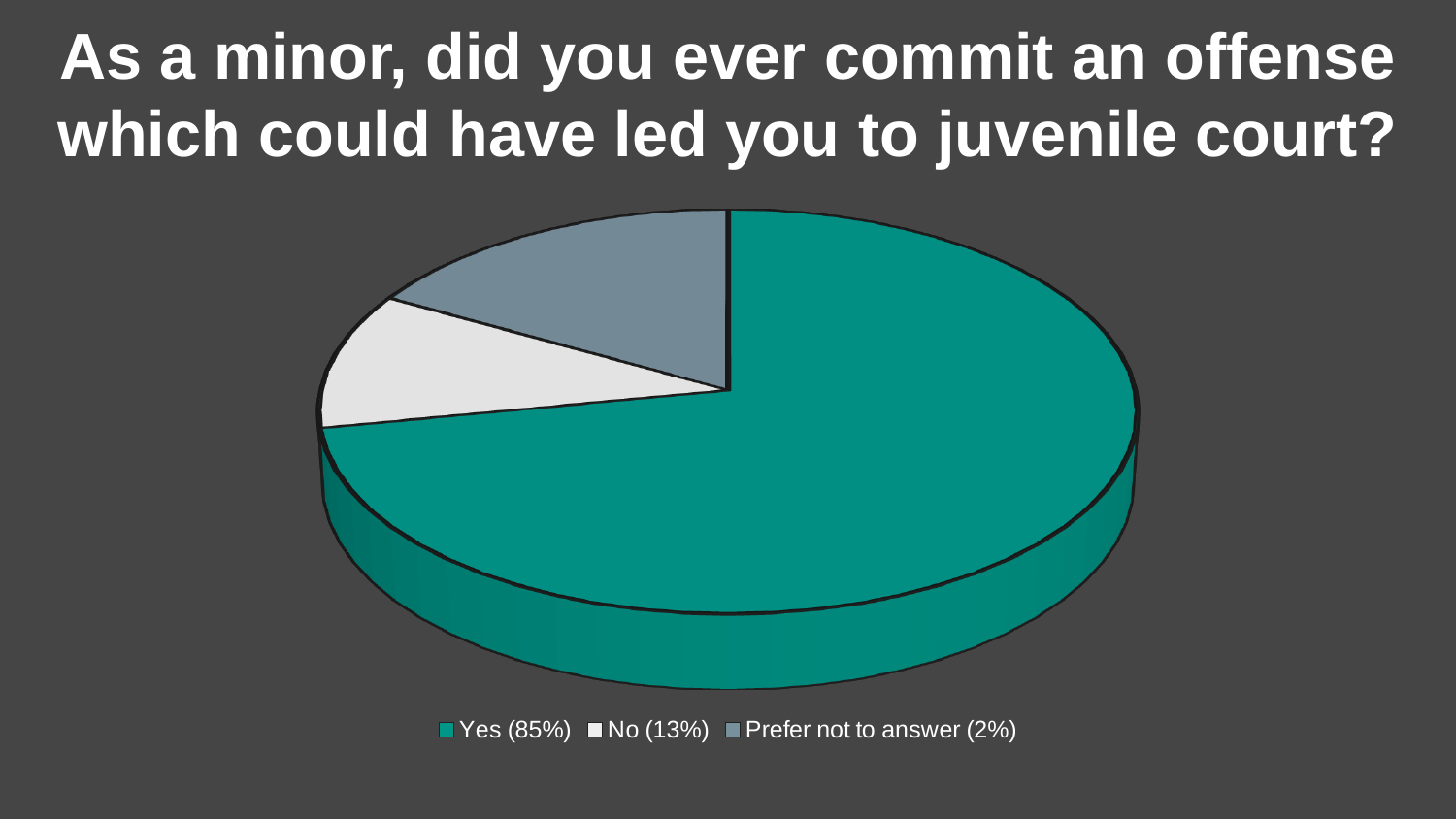
What share of the pie does the Yes slice represent? 85% What percentage of respondents answered No? 13% What is the title of the chart? As a minor, did you ever commit an offense which could have led you to juvenile court? What colour is the Yes slice of the pie? Teal What percentage of respondents answered Yes? 85% What percentage of respondents chose Prefer not to answer? 2% Which response has the largest share of the pie? Yes What kind of chart is shown on the slide? Pie chart What is the difference in percentage points between Yes and No? 72 Which is larger, the share for Yes or the share for No? Yes How many response categories are shown in the pie chart? 3